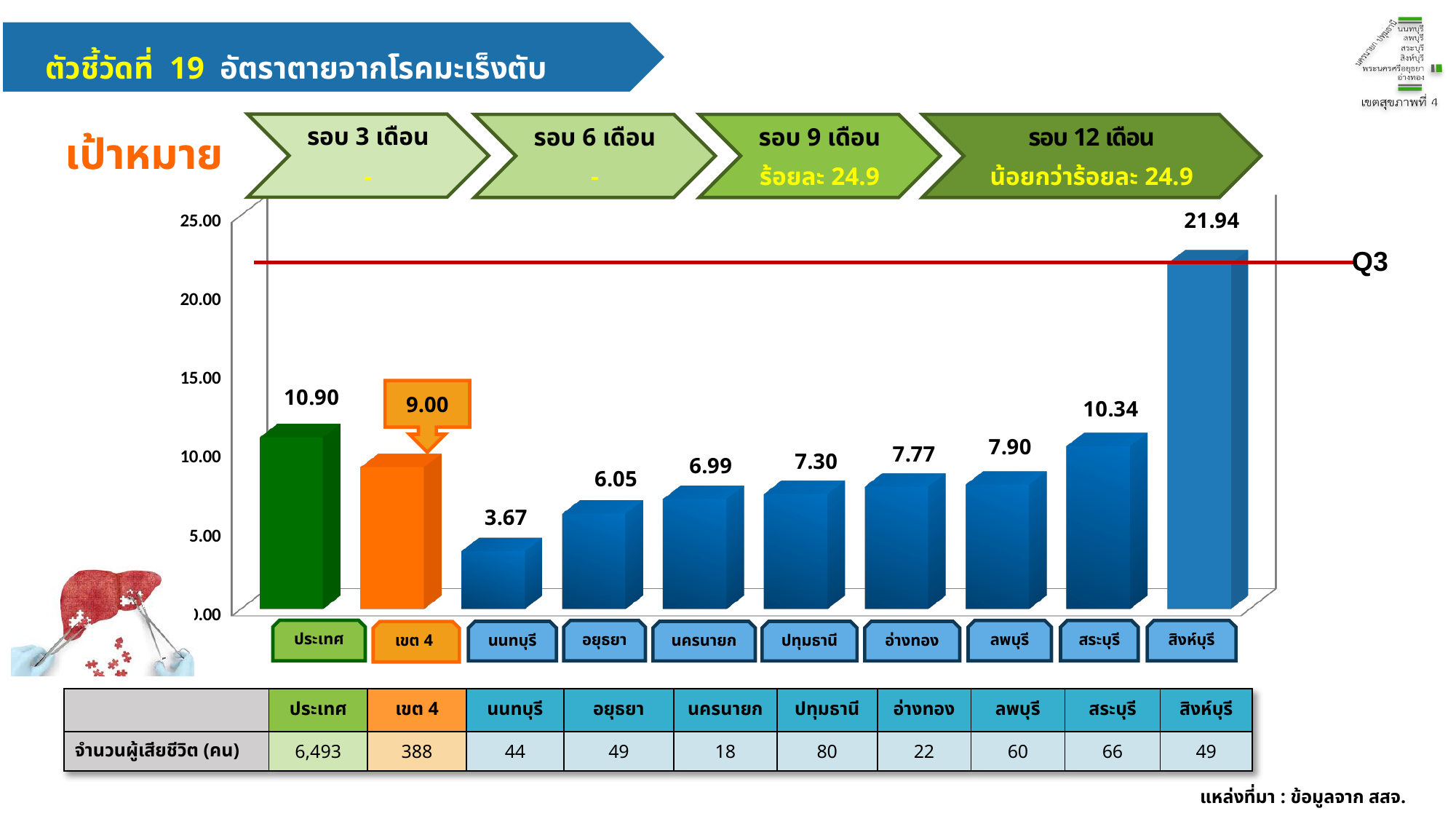
What is the difference between the values for สิงห์บุรี and สระบุรี? 11.60 Which category has the lowest value in the bar chart? นนทบุรี What is the value for สิงห์บุรี in the bar chart? 21.94 What is the value for นนทบุรี in the bar chart? 3.67 Which category has the highest value in the bar chart? สิงห์บุรี What kind of chart is shown on the slide? bar chart What is the value for เขต 4 in the bar chart? 9.00 Which is larger, the value for ประเทศ or the value for เขต 4? ประเทศ How many categories (bars) are shown in the bar chart? 10 What is the value for ประเทศ in the bar chart? 10.90 What is the label on the red horizontal line across the chart? Q3 Is the value for สิงห์บุรี greater or less than 20.00? greater